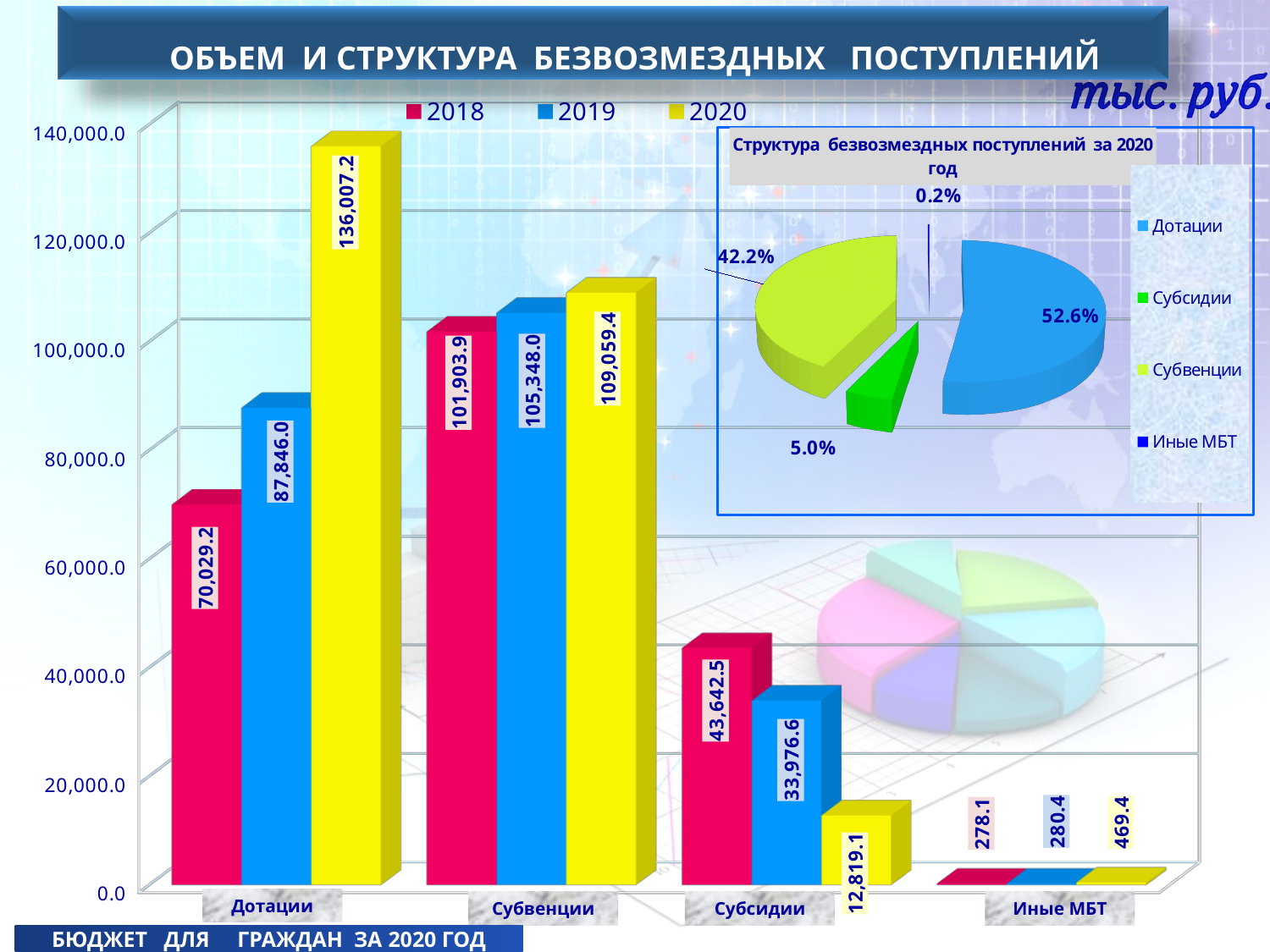
In the bar chart, what is the value for Дотации in 2020? 136,007.2 In the bar chart, which is larger for Субвенции: the 2018 value or the 2020 value? 2020 In the bar chart, what is the value for Субсидии in 2019? 33,976.6 How many categories are shown on the x axis of the bar chart? 4 In the bar chart, which category has the highest value for 2020? Дотации In the bar chart, what is the difference between the 2020 and 2018 values for Дотации? 65,978.0 In the bar chart, do the values for Субсидии rise or fall from 2018 to 2020? fall In the pie chart 'Структура безвозмездных поступлений за 2020 год', what share does Субвенции have? 42.2% In the pie chart 'Структура безвозмездных поступлений за 2020 год', which category has the smallest share? Иные МБТ How many series does the legend of the bar chart list? 3 In the bar chart, what is the value for Иные МБТ in 2018? 278.1 In the bar chart, which category has the lowest value for 2019? Иные МБТ